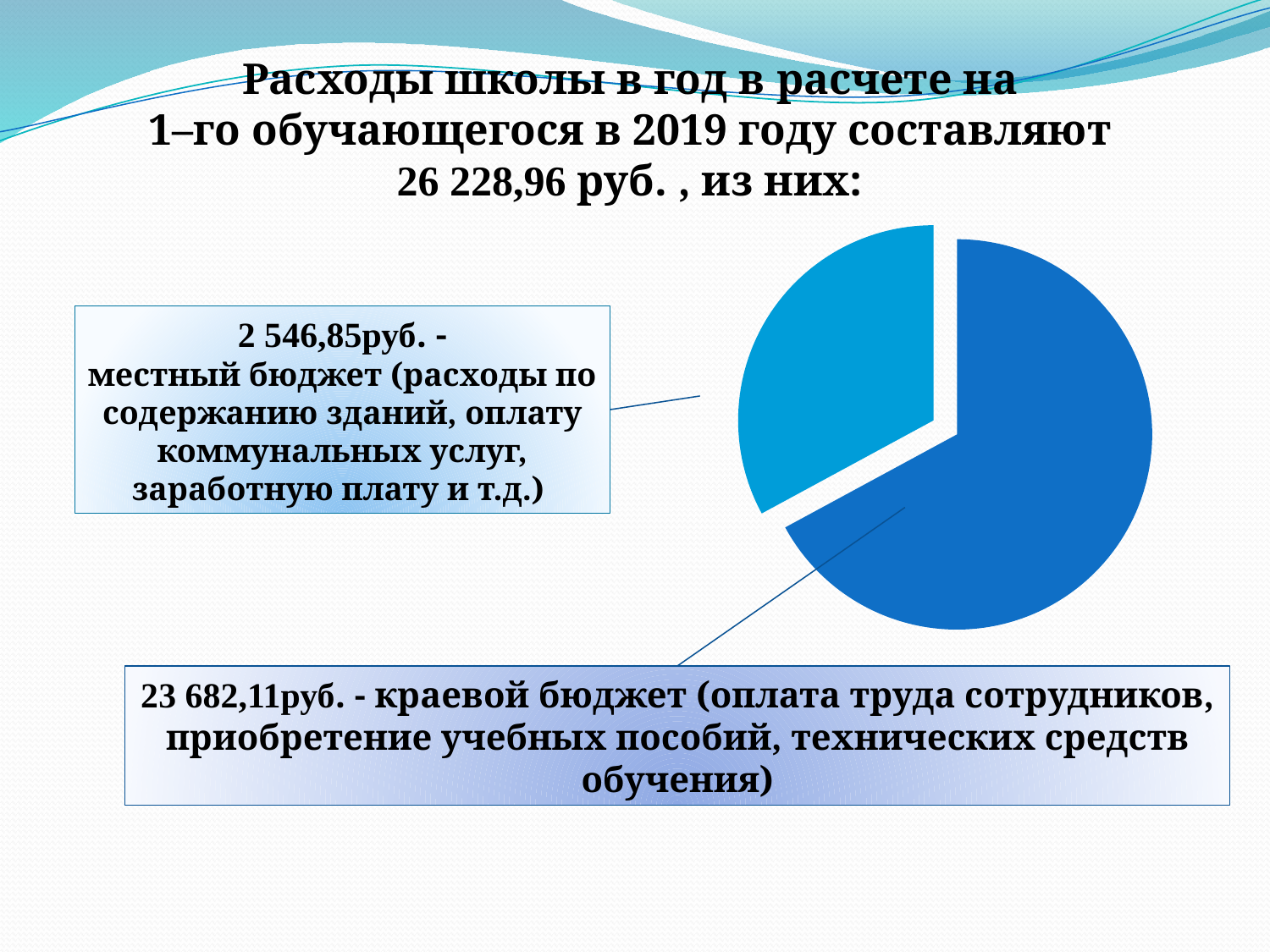
Which slice is pulled out (separated) from the rest of the pie? местный бюджет What kind of chart is shown on the slide? pie chart Which slice of the pie chart is the largest? краевой бюджет How many slices does the pie chart have? 2 Which is larger: the local budget or the regional budget expenses per student? краевой бюджет Which slice of the pie chart is the smallest? местный бюджет What is the value for the regional budget (краевой бюджет) slice? 23 682,11 руб. What colour is the slice representing the local budget (местный бюджет)? light blue What is the value for the local budget (местный бюджет) slice? 2 546,85 руб. What is the total of the two slices, as stated in the slide title? 26 228,96 руб. What is the difference between the regional budget and the local budget values? 21 135,26 руб.